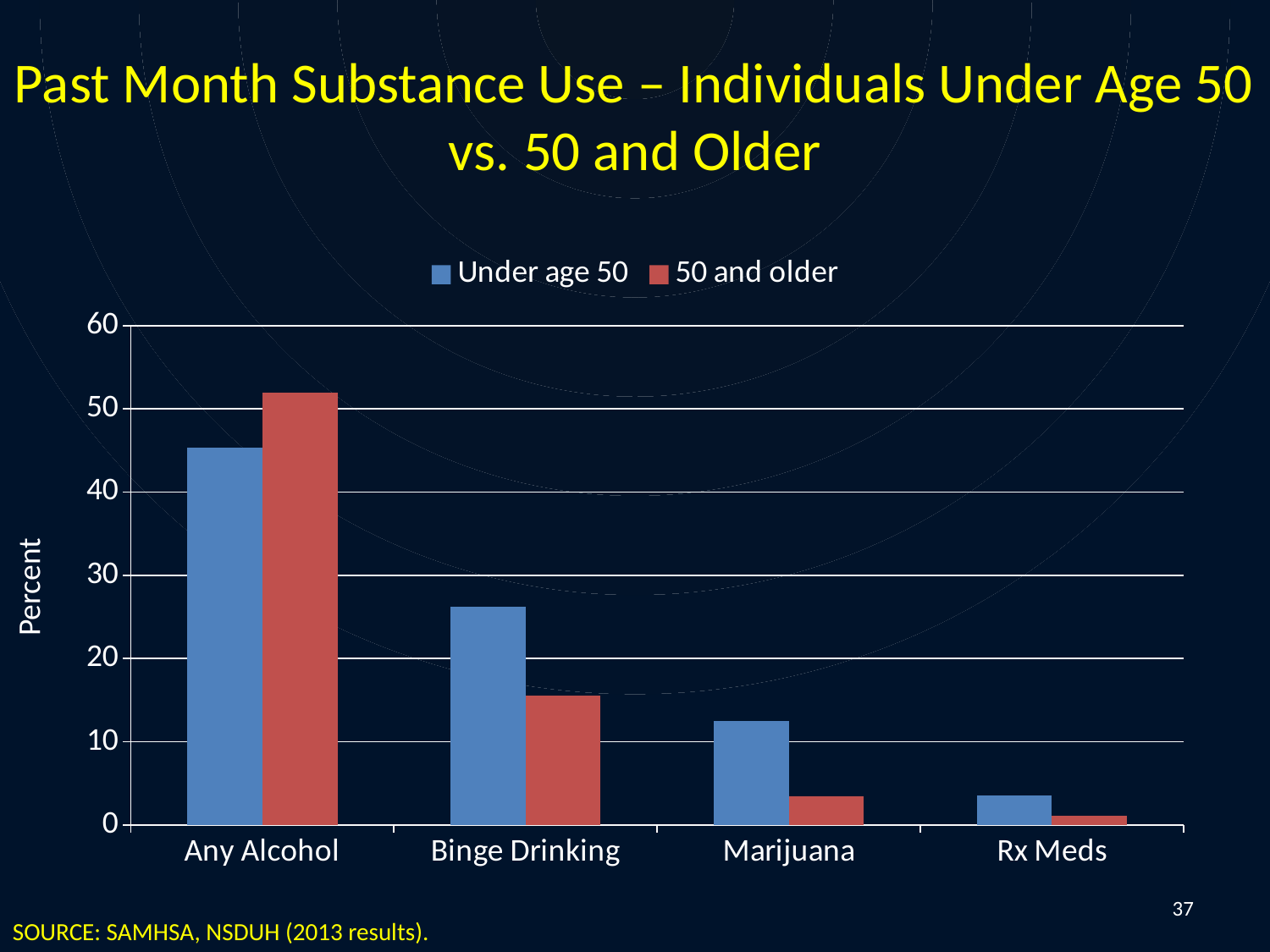
For Any Alcohol, which series has the larger value: Under age 50 or 50 and older? 50 and older Which category has the lowest value for the Under age 50 series? Rx Meds Which category has the highest value for the 50 and older series? Any Alcohol What kind of chart is shown on the slide? bar chart How many series does the legend list? 2 For Binge Drinking, which series has the larger value: Under age 50 or 50 and older? Under age 50 How many categories are shown on the x axis? 4 What is the label on the y axis? Percent Is the Under age 50 value for Marijuana greater or less than 10? greater Is the 50 and older value for Binge Drinking greater or less than 20? less Is the Under age 50 value for Any Alcohol greater or less than 40? greater Do the Under age 50 values rise or fall moving from Any Alcohol to Rx Meds along the x axis? fall